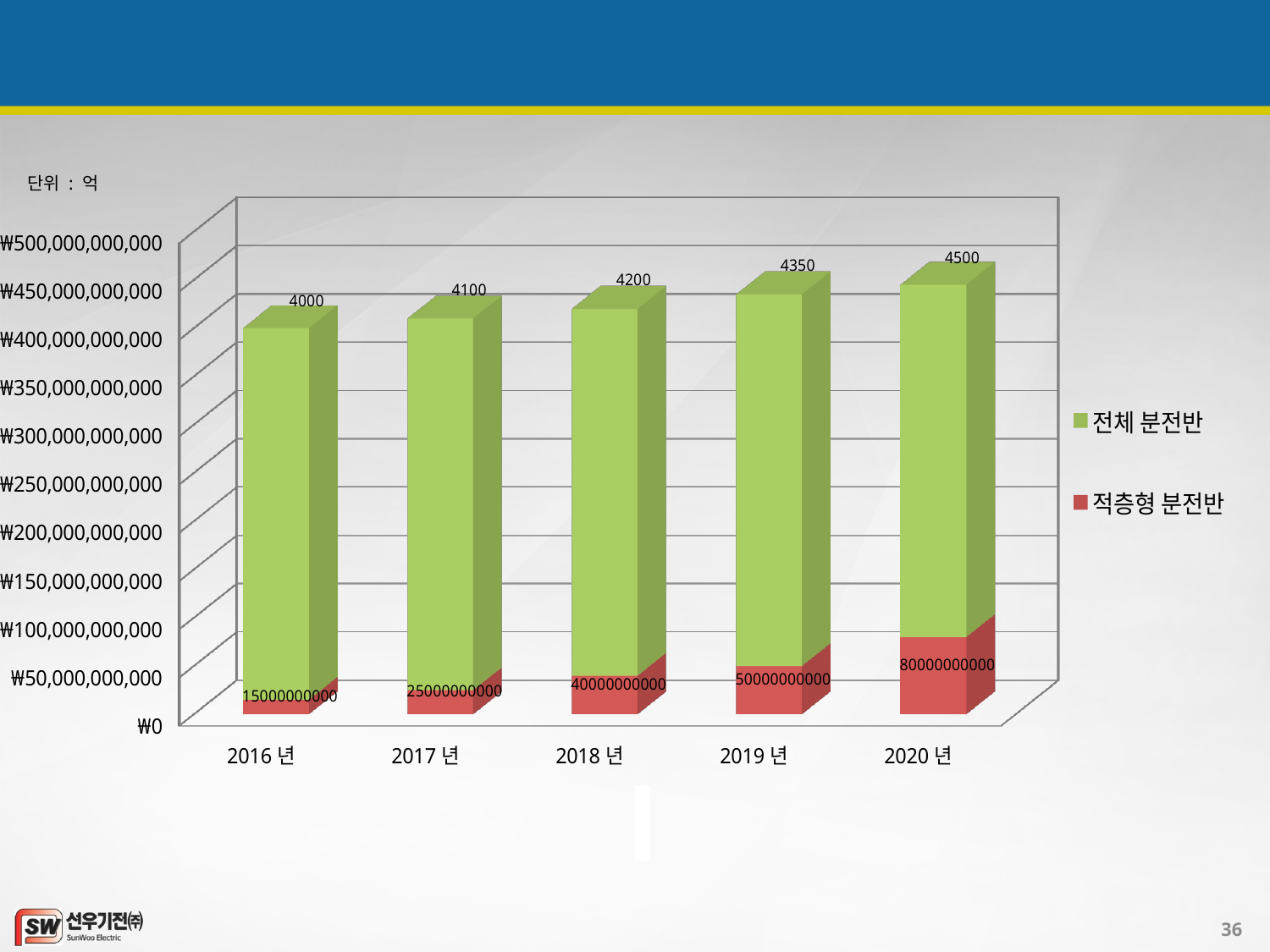
How many years are shown on the x axis? 5 Do the 적층형 분전반 values rise or fall from 2016 년 to 2020 년? rise What is the data label for 전체 분전반 in 2019 년? 4350 What is the data label for 적층형 분전반 in 2018 년? 40000000000 What is the data label for 적층형 분전반 in 2020 년? 80000000000 Which year has the highest value for 적층형 분전반? 2020 년 What is the difference between the 전체 분전반 labels for 2020 년 and 2016 년? 500 Which series is shown in green in the legend? 전체 분전반 How many series does the legend list? 2 What is the data label for 전체 분전반 in 2016 년? 4000 What type of chart is shown on the slide? bar chart